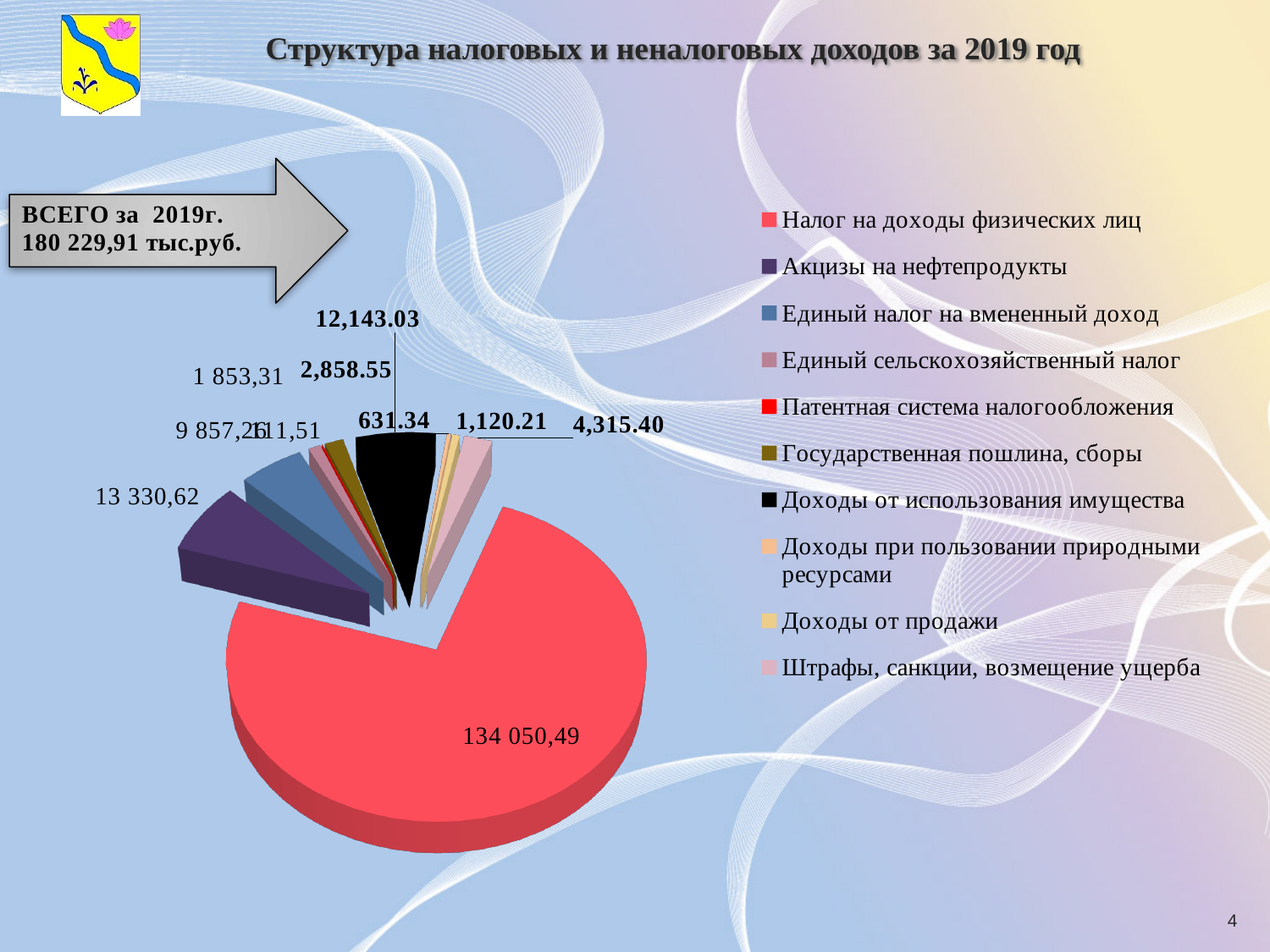
How many categories does the legend of the pie chart list? 10 What value is shown for Акцизы на нефтепродукты? 13 330,62 What value is shown for Единый налог на вмененный доход? 9 857,26 What value is shown for Налог на доходы физических лиц? 134 050,49 What total amount for 2019 is shown in the arrow box on the slide? 180 229,91 тыс.руб. What type of chart is shown on the slide? Pie chart What value is shown for Доходы от использования имущества? 12,143.03 Which is larger: Акцизы на нефтепродукты or Единый налог на вмененный доход? Акцизы на нефтепродукты What is the title of the chart on the slide? Структура налоговых и неналоговых доходов за 2019 год What is the difference between Акцизы на нефтепродукты and Единый налог на вмененный доход? 3 473,36 Which category has the largest slice of the pie chart? Налог на доходы физических лиц What value is shown for Штрафы, санкции, возмещение ущерба? 4,315.40